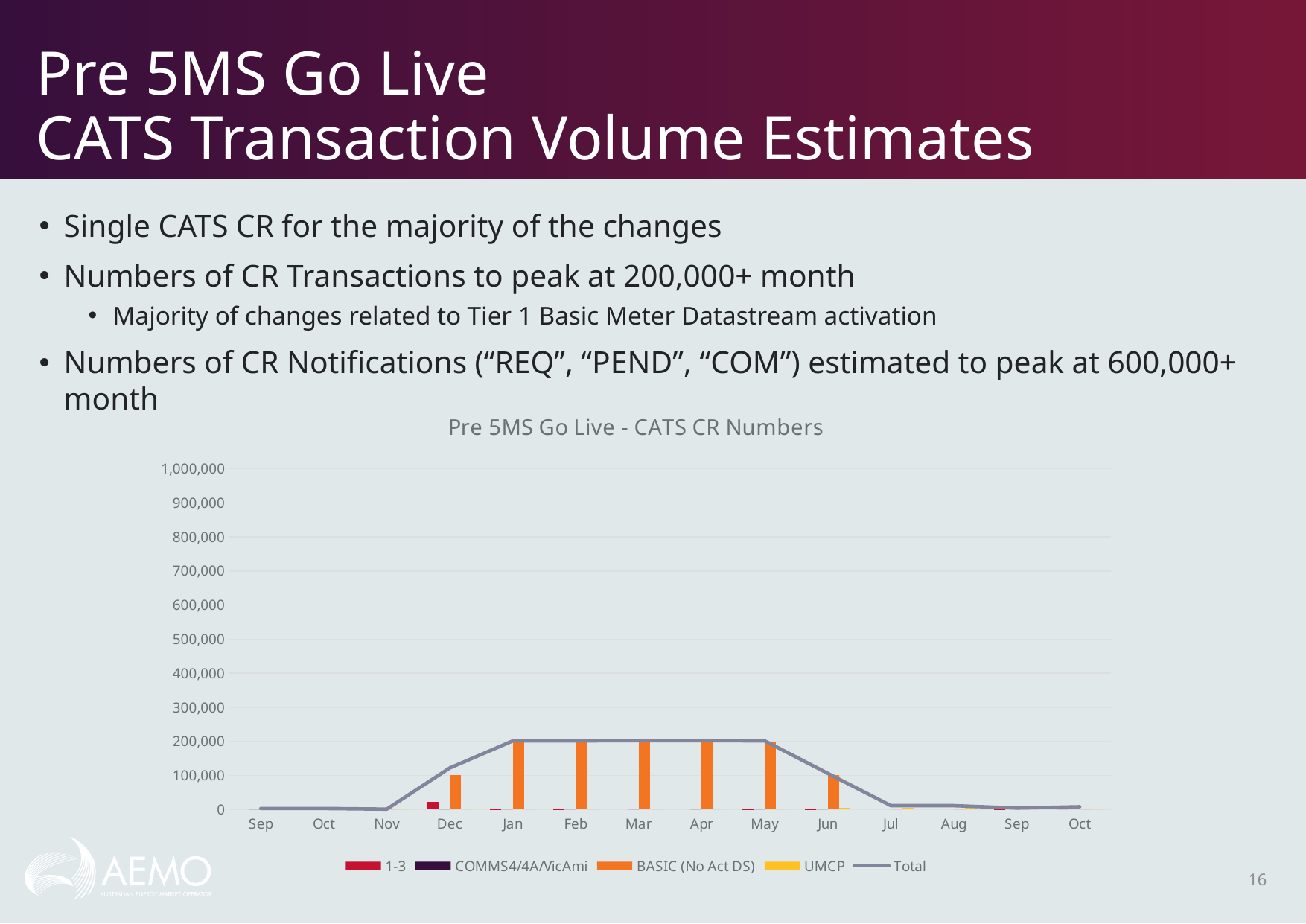
Does the Total line rise or fall from May to Jul? fall What is the title of the chart? Pre 5MS Go Live - CATS CR Numbers Is the BASIC (No Act DS) value for Dec greater or less than 150,000? less Which series is drawn as a line rather than bars? Total Is the Total value for Nov greater or less than 100,000? less Is the Total value for Mar greater or less than 300,000? less Does the Total line rise or fall from Nov to Jan? rise How many series does the chart legend list? 5 Which month has the larger BASIC (No Act DS) bar, Dec or Jan? Jan What kind of chart is shown on the slide? A combined bar and line chart How many months are shown along the x axis of the chart? 14